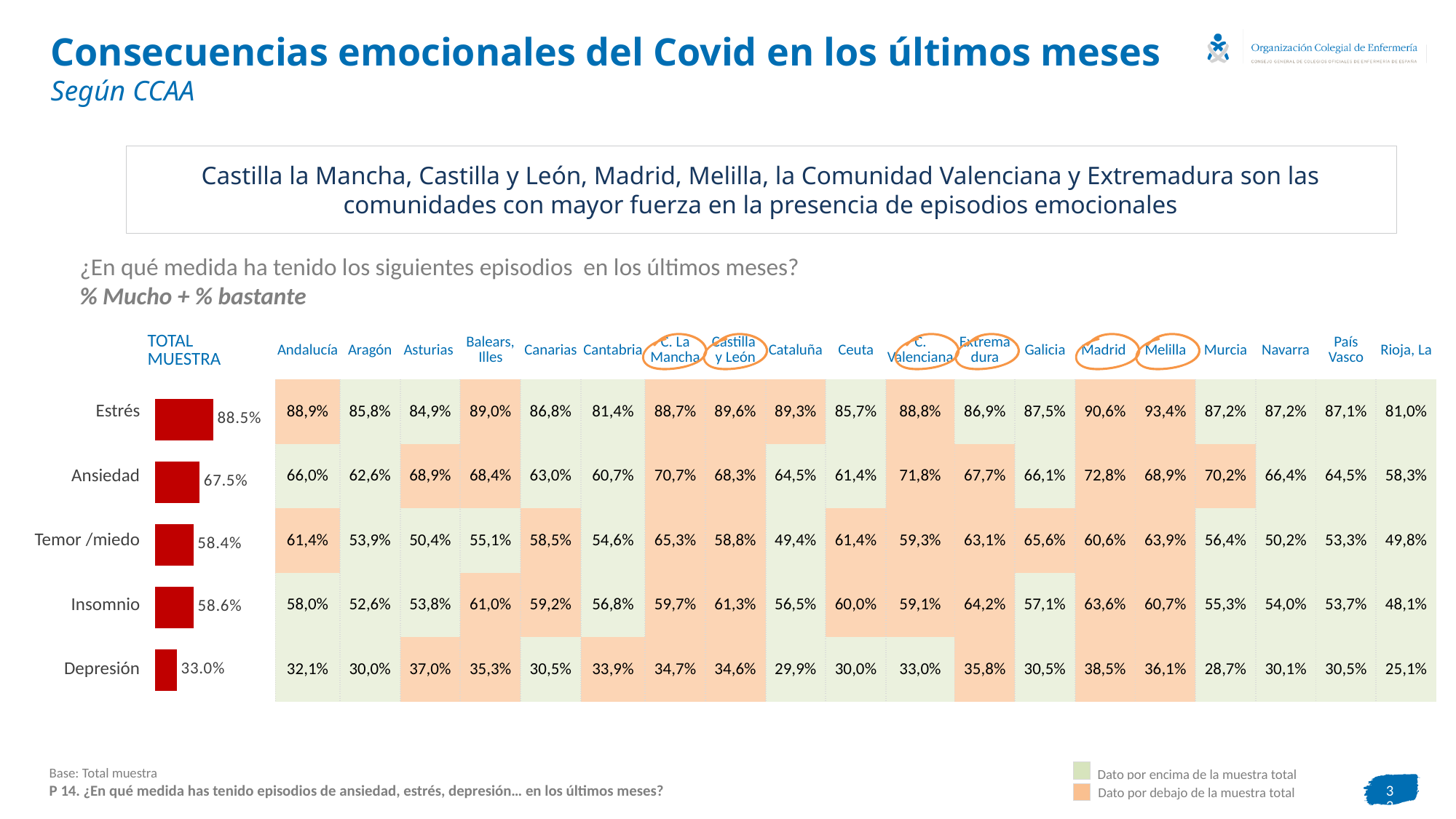
How many categories does the TOTAL MUESTRA bar chart show? 5 In the table next to the bar chart, what is the Estrés value for Melilla? 93,4% In the TOTAL MUESTRA bar chart, which is larger, the value for Ansiedad or the value for Depresión? Ansiedad In the TOTAL MUESTRA bar chart, what is the difference between the values for Insomnio and Temor /miedo? 0.2% In the TOTAL MUESTRA bar chart, what is the value for Insomnio? 58.6% In the TOTAL MUESTRA bar chart, what is the value for Estrés? 88.5% In the TOTAL MUESTRA bar chart, what is the value for Depresión? 33.0% In the TOTAL MUESTRA bar chart, what is the difference between the values for Estrés and Ansiedad? 21.0% In the TOTAL MUESTRA bar chart, which category has the highest value? Estrés In the TOTAL MUESTRA bar chart, what is the value for Ansiedad? 67.5% In the TOTAL MUESTRA bar chart, which category has the lowest value? Depresión What kind of chart is the TOTAL MUESTRA chart on the slide? bar chart